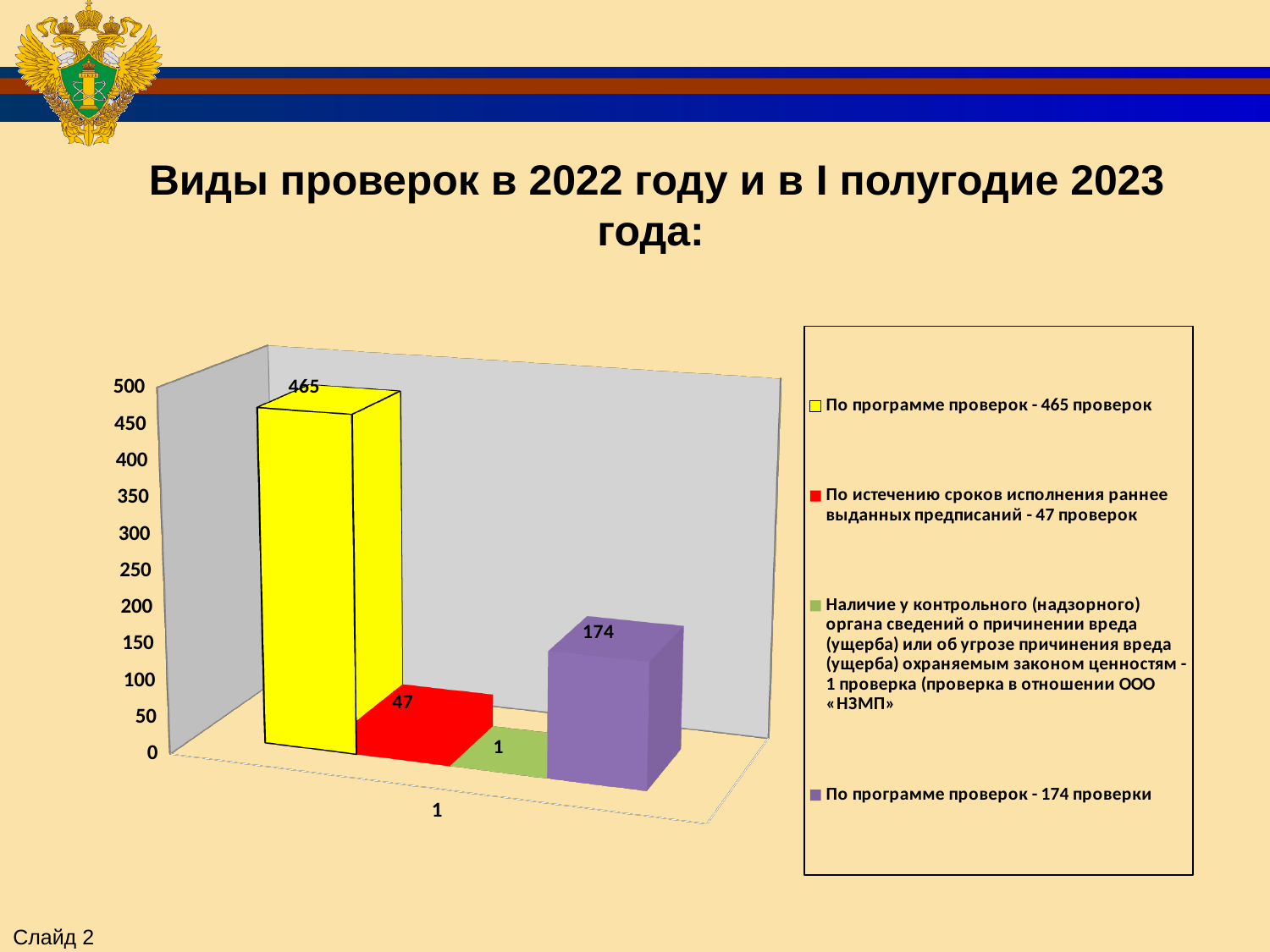
What is the difference between the yellow bar (465) and the purple bar (174)? 291 What value is shown for the red bar (По истечению сроков исполнения раннее выданных предписаний)? 47 What is the title of the slide? Виды проверок в 2022 году и в I полугодие 2023 года: What kind of chart is shown on the slide? bar chart What value is shown for the yellow bar (По программе проверок - 465 проверок)? 465 How many series does the legend list? 4 What is the difference between the purple bar (174) and the red bar (47)? 127 Which series has the highest value? По программе проверок - 465 проверок Which is larger, the red bar or the purple bar? the purple bar (174) What value is shown for the purple bar (По программе проверок - 174 проверки)? 174 What value is shown for the green bar (Наличие у контрольного (надзорного) органа сведений о причинении вреда)? 1 Which series has the lowest value? Наличие у контрольного (надзорного) органа сведений о причинении вреда (ущерба) или об угрозе причинения вреда (ущерба) охраняемым законом ценностям - 1 проверка